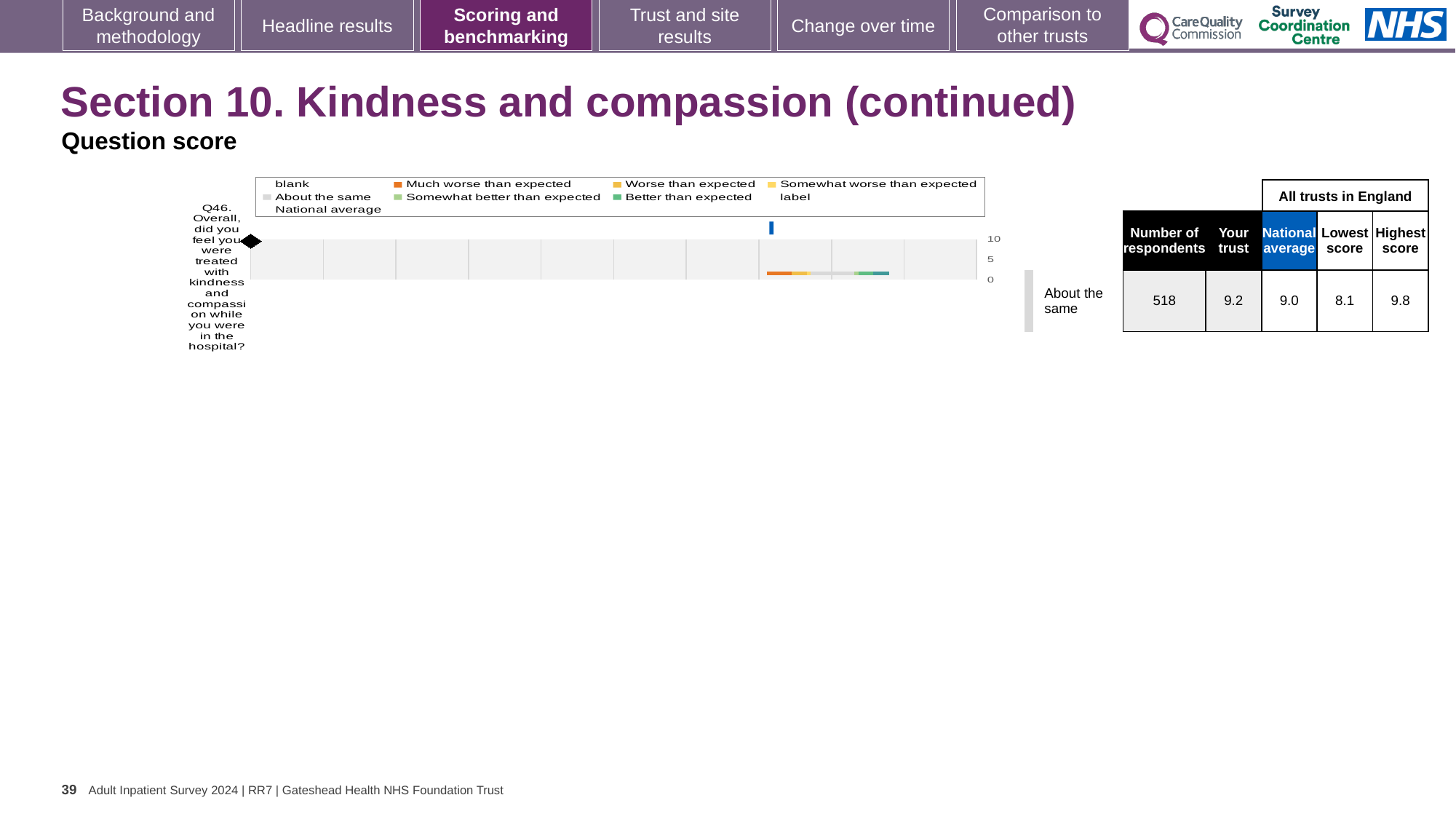
What is the lowest score among all trusts in England for Q46? 8.1 What is the national average score for Q46? 9.0 What is the 'Your trust' score for Q46? 9.2 What kind of chart is shown on the slide? bar chart How many survey questions are plotted in the chart? 1 What is the difference between the highest score and the lowest score for Q46? 1.7 What is the highest score among all trusts in England for Q46? 9.8 By how much does the 'Your trust' score exceed the national average for Q46? 0.2 How many respondents answered Q46? 518 Which is larger for Q46, the 'Your trust' score or the national average? Your trust Which question number is plotted in the chart? Q46 Which benchmarking category is the trust's score for Q46 placed in? About the same